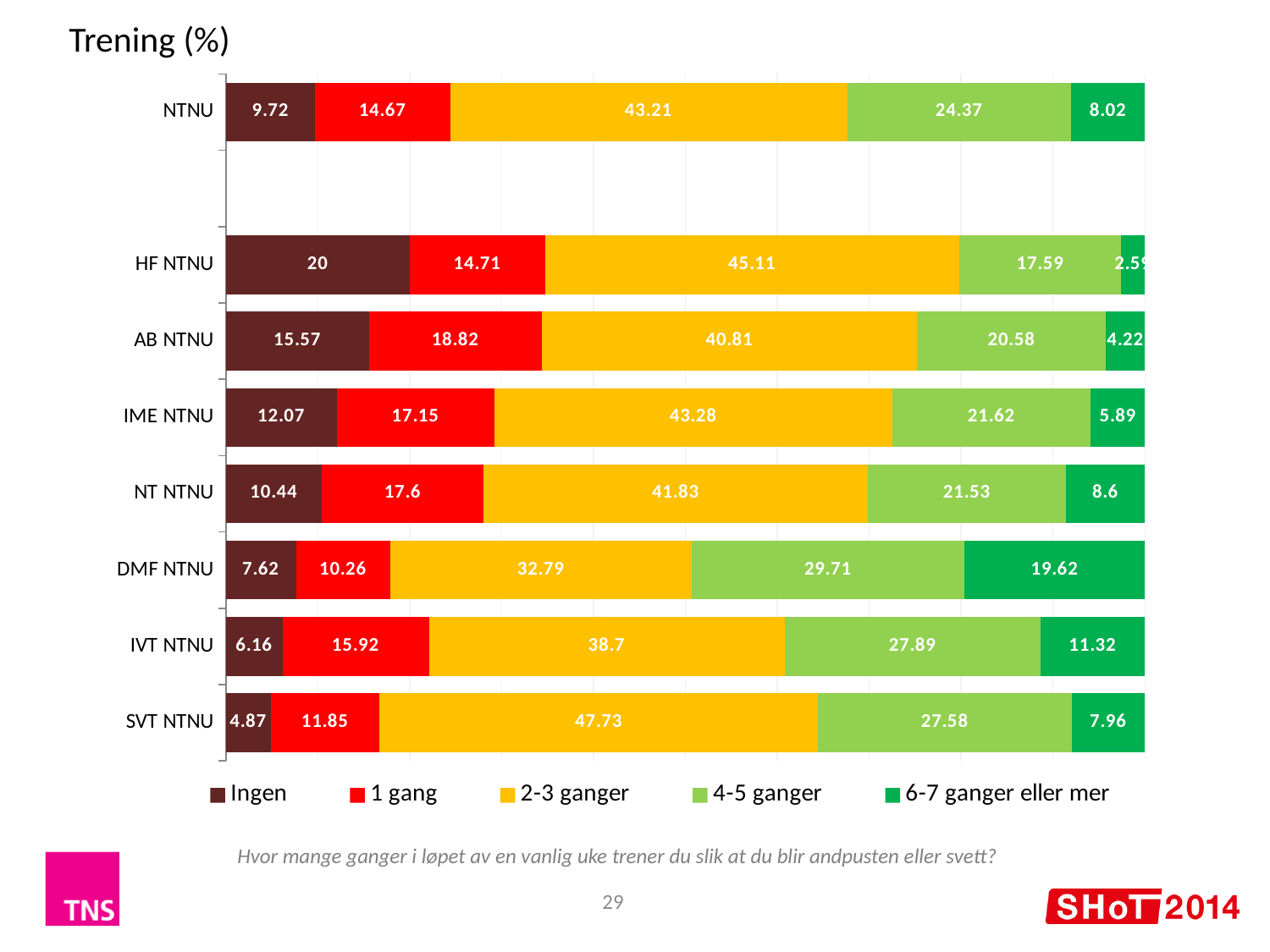
Which category has the lowest value for 'Ingen'? SVT NTNU What is the difference between the '1 gang' values for AB NTNU and SVT NTNU? 6.97 What is the value for 'Ingen' for HF NTNU? 20 Which is larger: the '4-5 ganger' value for DMF NTNU or for NT NTNU? DMF NTNU What is the value for '4-5 ganger' for IVT NTNU? 27.89 What is the value for '2-3 ganger' for NTNU? 43.21 What kind of chart is shown on the slide? Stacked bar chart How many series does the legend list? 5 What is the value for '6-7 ganger eller mer' for DMF NTNU? 19.62 How many categories are shown on the y axis? 8 Which category has the highest value for '2-3 ganger'? SVT NTNU Which category has the highest value for 'Ingen'? HF NTNU